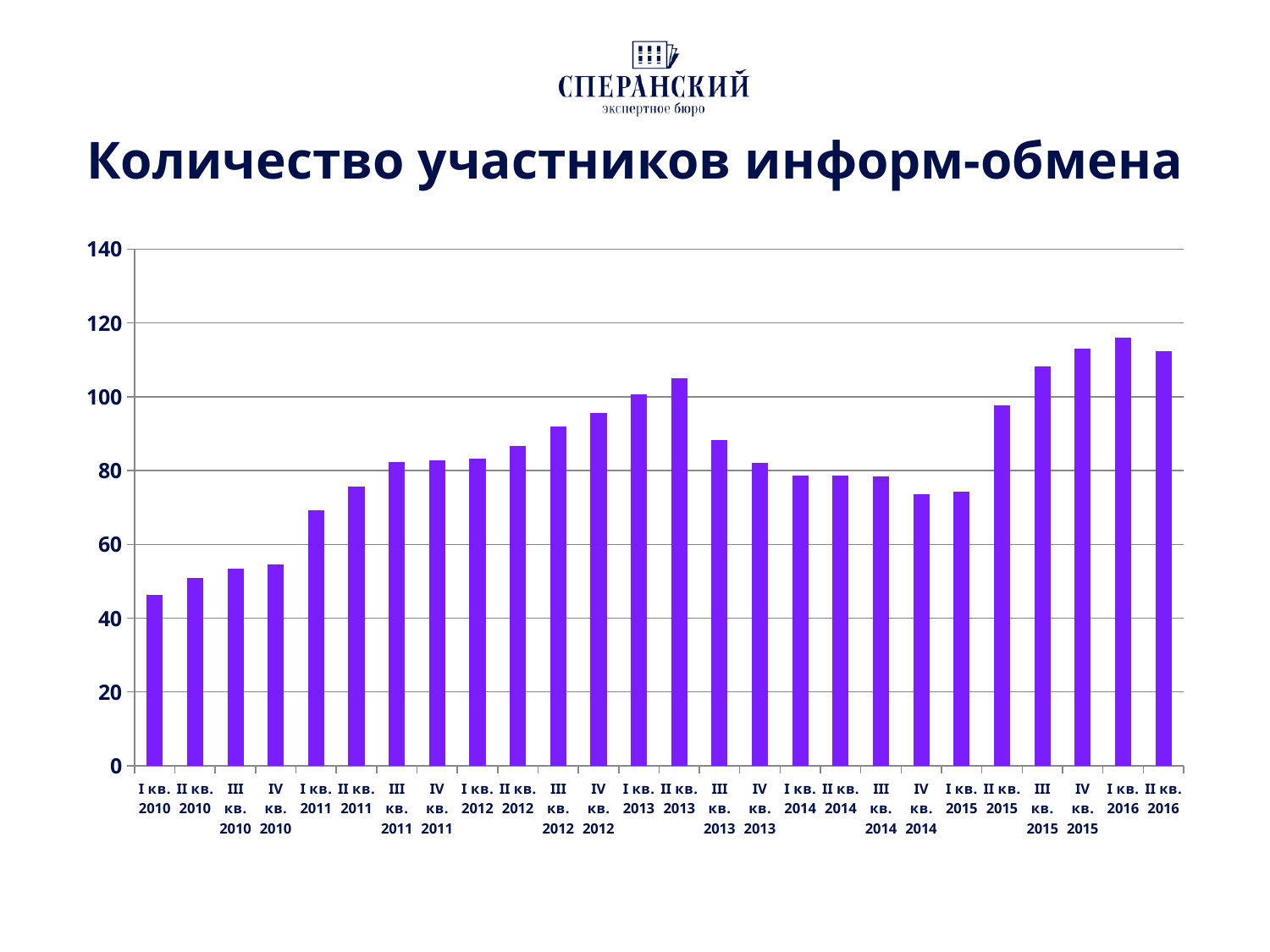
What is the title of the chart? Количество участников информ-обмена Which is larger, the value for II кв. 2013 or the value for III кв. 2013? II кв. 2013 What kind of chart is shown on the slide? bar chart Is the value for IV кв. 2014 greater or less than 80? less Which quarter has the highest value in the chart? I кв. 2016 Which is larger, the value for I кв. 2015 or the value for II кв. 2015? II кв. 2015 Do the values generally rise or fall from I кв. 2010 to II кв. 2013? rise Which quarter has the lowest value in the chart? I кв. 2010 How many bars (quarters) are plotted in the chart? 26 Is the value for I кв. 2010 greater or less than 60? less Is the value for II кв. 2013 greater or less than 100? greater